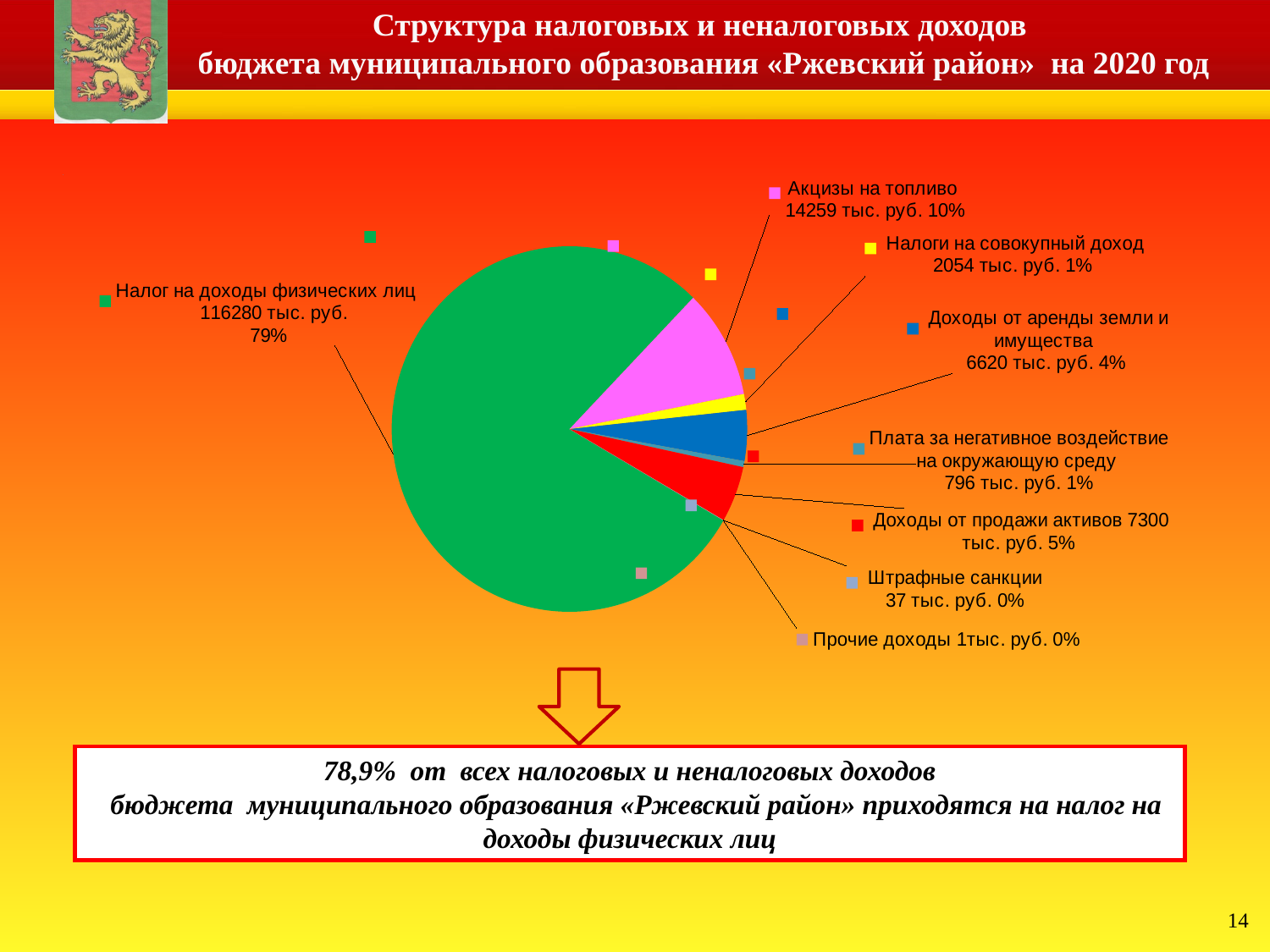
What share of the pie does «Плата за негативное воздействие на окружающую среду» account for? 1% What is the difference between the values for «Доходы от продажи активов» and «Доходы от аренды земли и имущества»? 680 тыс. руб. What kind of chart is shown on the slide? Pie chart What is the value shown for «Штрафные санкции»? 37 тыс. руб. Which is larger: «Акцизы на топливо» or «Доходы от продажи активов»? Акцизы на топливо What colour is the slice for «Доходы от продажи активов»? Red Which category has the largest slice of the pie? Налог на доходы физических лиц Which category has the smallest value in the pie chart? Прочие доходы What share of the pie does «Акцизы на топливо» account for? 10% How many categories (slices) does the pie chart show? 8 What is the value shown for «Доходы от аренды земли и имущества»? 6620 тыс. руб. What is the value shown for «Налог на доходы физических лиц»? 116280 тыс. руб.